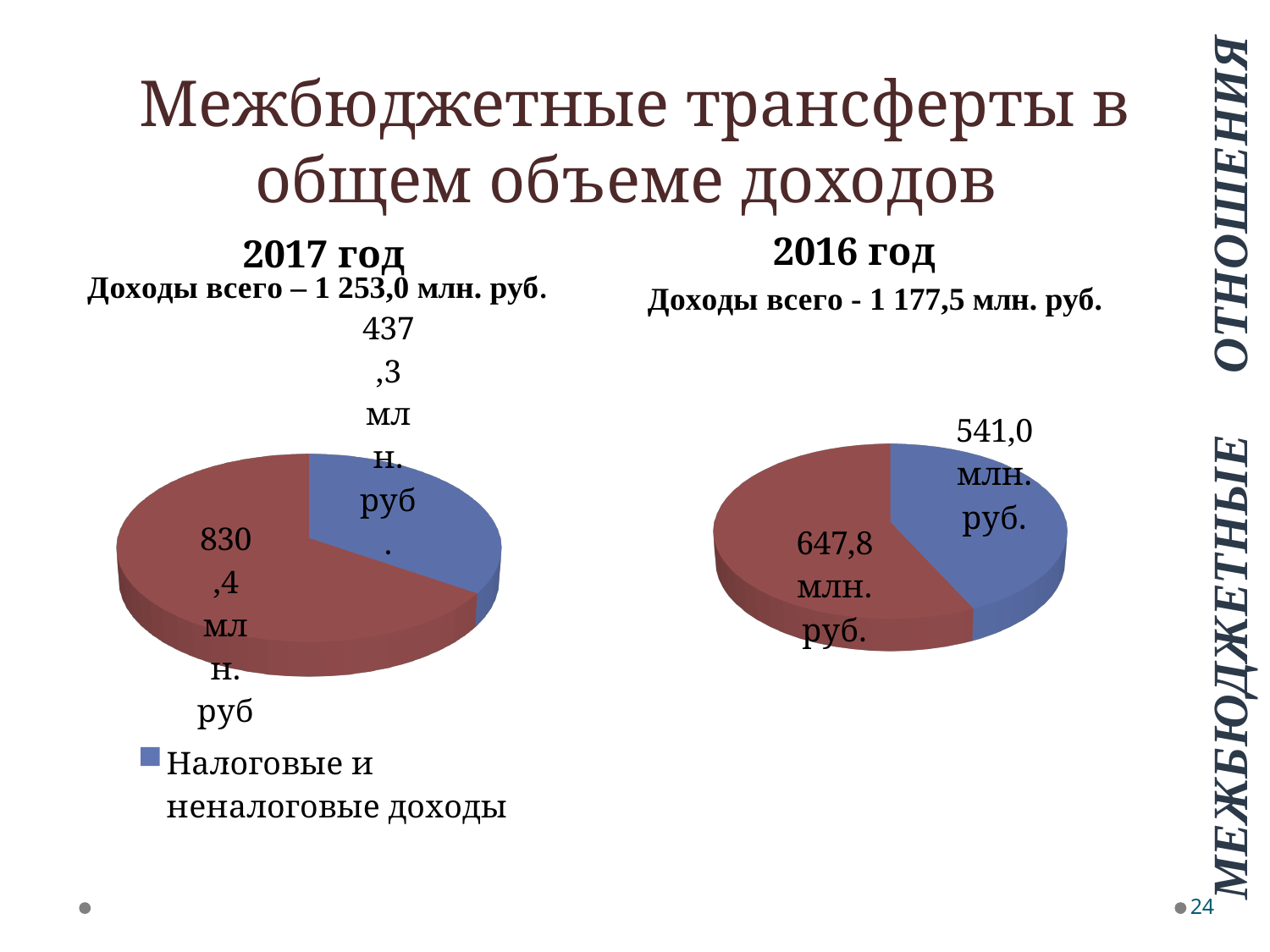
What type of chart is used for the 2017 год and 2016 год data? Pie chart How many slices does the 2016 год pie chart have? 2 In the 2017 год pie chart, which slice is larger, the blue one or the red one? The red one Which chart has the larger blue slice value, 2017 год or 2016 год? 2016 год In the 2016 год pie chart, which slice is larger, the blue one or the red one? The red one In the 2017 год pie chart, what legend entry is shown for the blue slice? Налоговые и неналоговые доходы In the 2016 год pie chart, what value is shown for the blue slice? 541,0 млн. руб. In the 2017 год pie chart, what value is shown for the blue slice? 437,3 млн. руб. In the 2017 год pie chart, what is the difference between the red slice and the blue slice? 393,1 млн. руб. In the 2016 год pie chart, what is the difference between the red slice and the blue slice? 106,8 млн. руб. In the 2016 год pie chart, what value is shown for the red slice? 647,8 млн. руб. In the 2017 год pie chart, what value is shown for the red slice? 830,4 млн. руб.